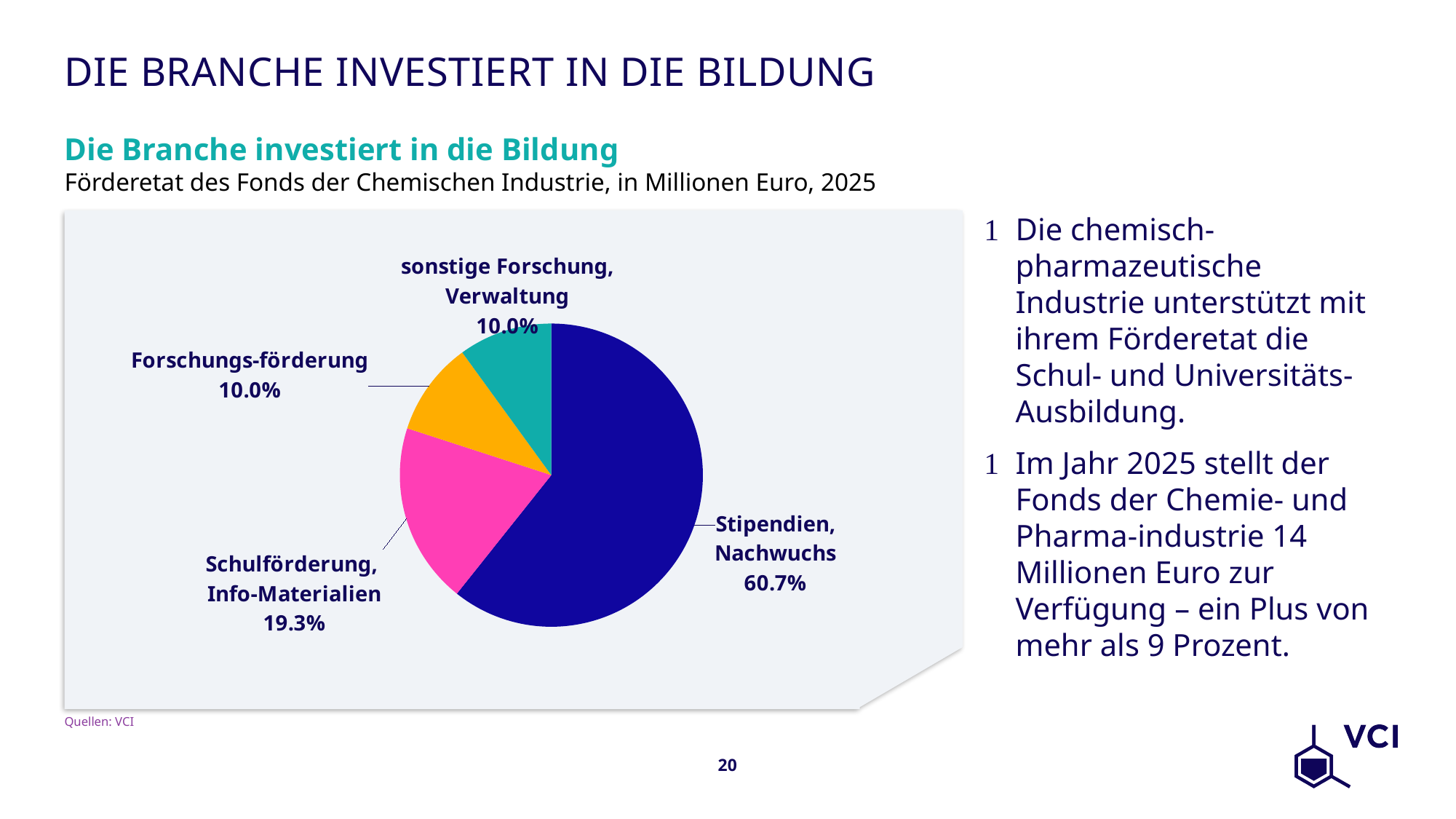
What is the value shown for Forschungs-förderung? 10.0% Is the share for Stipendien, Nachwuchs greater or less than 50%? greater What kind of chart is shown on the slide? Pie chart What is the title of the chart? Die Branche investiert in die Bildung Which category has the largest slice of the pie? Stipendien, Nachwuchs How many slices does the pie chart have? 4 What share of the pie does Schulförderung, Info-Materialien account for? 19.3% What is the value shown for sonstige Forschung, Verwaltung? 10.0% What colour is the Stipendien, Nachwuchs slice? Dark blue What share of the pie does Stipendien, Nachwuchs account for? 60.7% What is the difference in percentage points between Stipendien, Nachwuchs and Schulförderung, Info-Materialien? 41.4 Which is larger: Schulförderung, Info-Materialien or Forschungs-förderung? Schulförderung, Info-Materialien